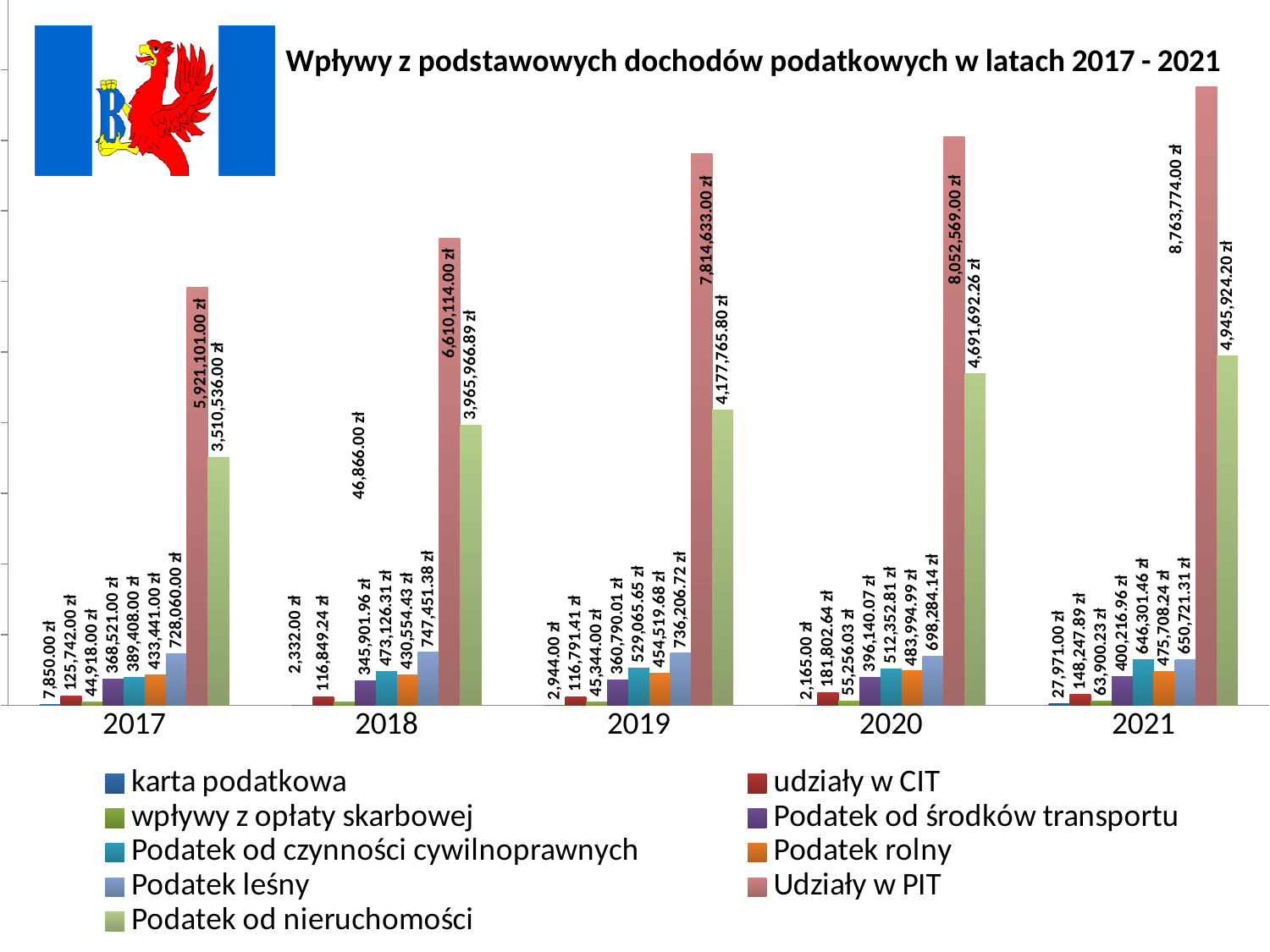
What is the title of the chart? Wpływy z podstawowych dochodów podatkowych w latach 2017 - 2021 What is the value of Udziały w PIT in 2019? 7,814,633.00 zł How many series does the legend list? 9 What is the difference between Udziały w PIT in 2021 and in 2020? 711,205.00 zł What kind of chart is shown on the slide? bar chart Which is larger in 2020: Podatek rolny or Podatek od czynności cywilnoprawnych? Podatek od czynności cywilnoprawnych What is the value of Podatek leśny in 2018? 747,451.38 zł What is the value of Podatek od nieruchomości in 2021? 4,945,924.20 zł How many years are shown on the x axis? 5 In which year is Udziały w PIT the highest? 2021 In which year is Podatek od nieruchomości the lowest? 2017 Do the values of Udziały w PIT rise or fall from 2017 to 2021? rise